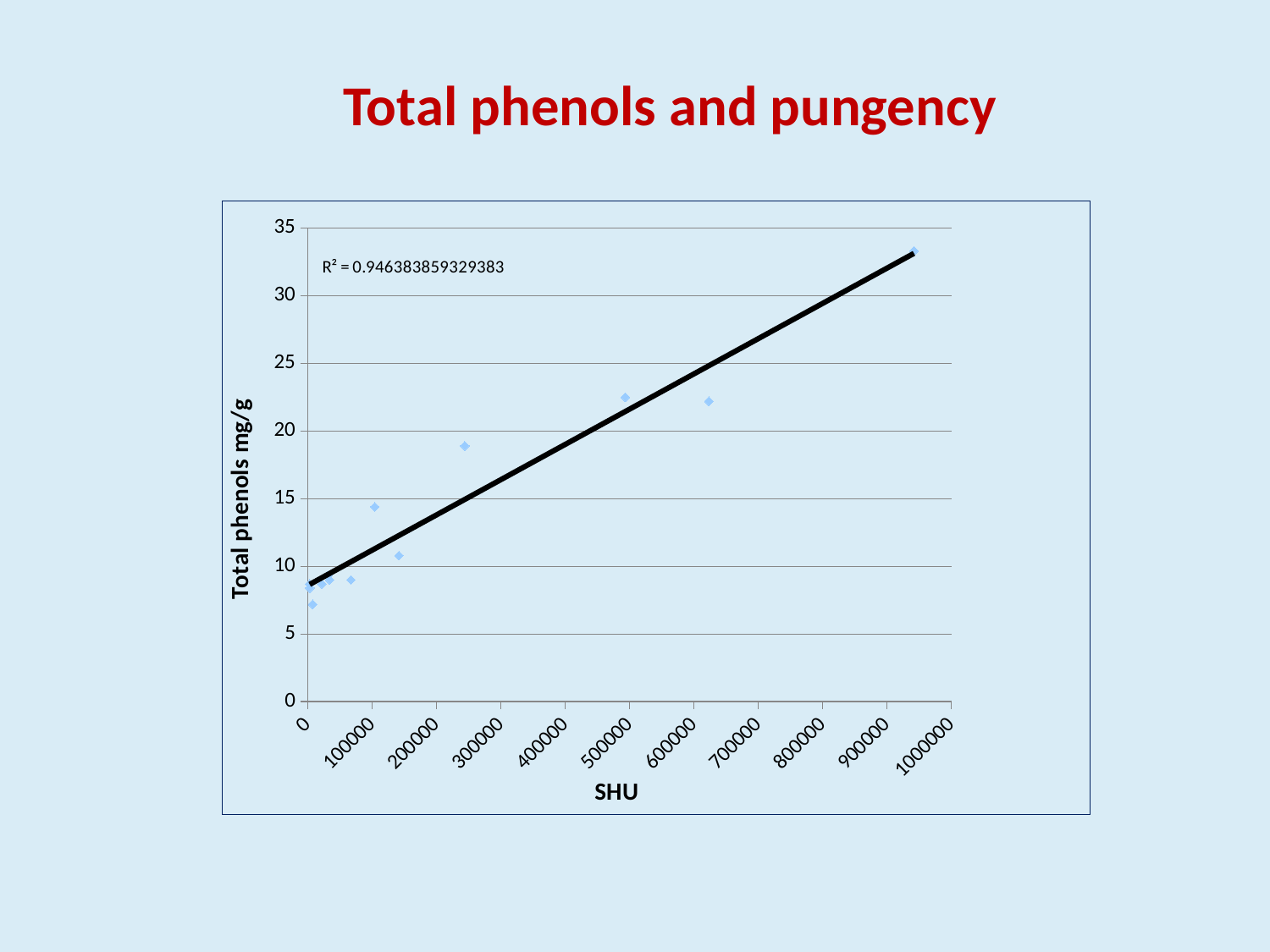
Is the lowest total phenols value plotted greater or less than 10? less What is the title of the chart? Total phenols and pungency What kind of chart is shown on the slide? scatter chart What is the label of the y axis? Total phenols mg/g Is the total phenols value for the point near 250000 SHU greater or less than 20? less Do total phenols values generally rise or fall as SHU increases along the x axis? rise Is the total phenols value for the point near 250000 SHU greater or less than 15? greater What is the highest value shown on the x axis? 1000000 Which has the larger total phenols value: the point near 500000 SHU or the point near 250000 SHU? the point near 500000 SHU What R² value is printed on the chart? R² = 0.946383859329383